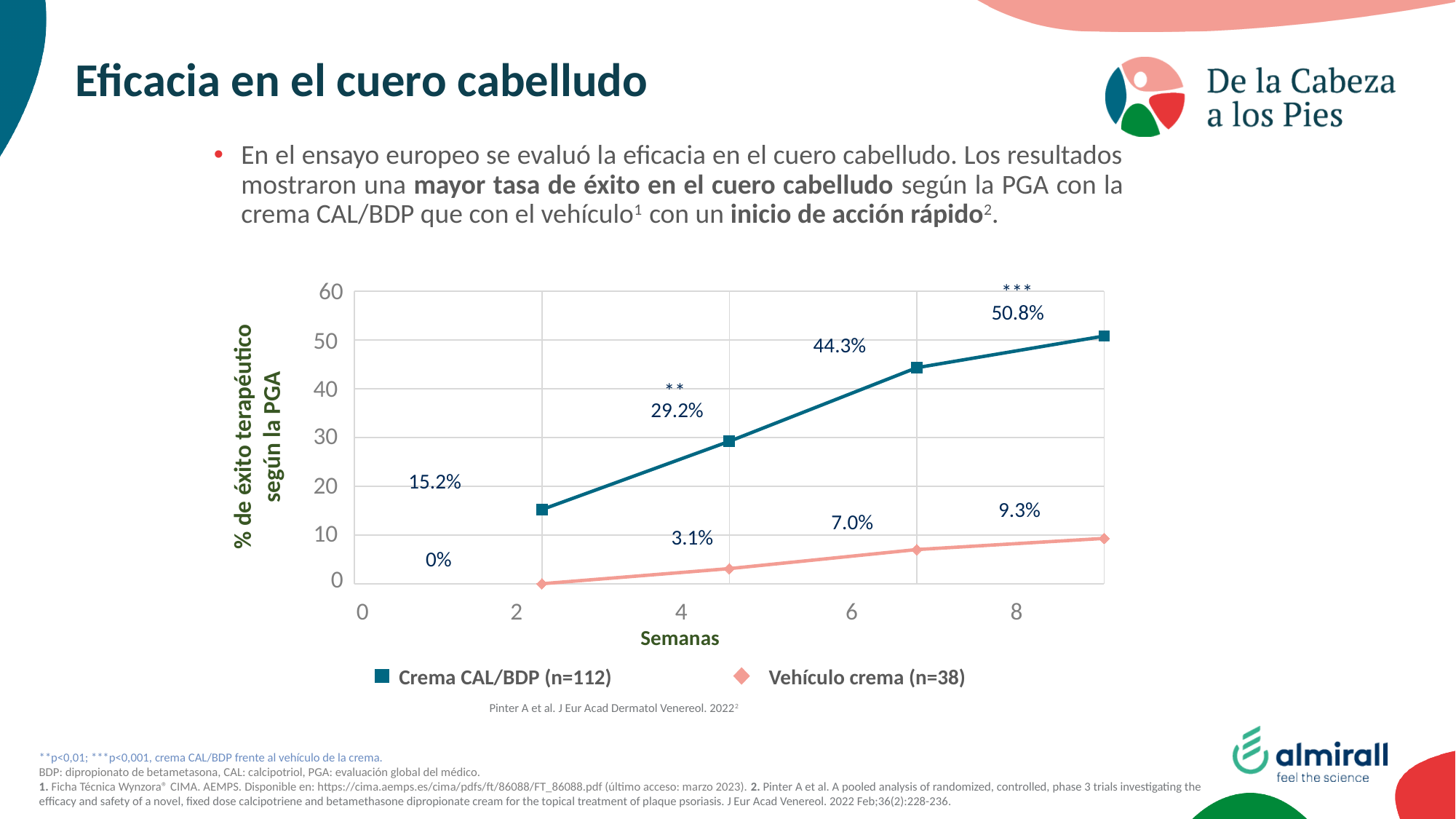
What is the difference between the final values of Crema CAL/BDP (n=112) and Vehículo crema (n=38)? 41.5% Which series has the higher value at the third data point: Crema CAL/BDP (n=112) or Vehículo crema (n=38)? Crema CAL/BDP (n=112) What is the highest value shown for Vehículo crema (n=38)? 9.3% Do the values for Crema CAL/BDP (n=112) rise or fall as the weeks increase? rise What is the value of the third data point for Vehículo crema (n=38)? 7.0% How many series does the legend list? 2 What is the value of the second data point for Crema CAL/BDP (n=112)? 29.2% What is the value of the last (rightmost) data point for Crema CAL/BDP (n=112)? 50.8% What type of chart is shown on the slide? line chart What is the label of the x axis? Semanas What is the value of the first data point for Vehículo crema (n=38)? 0% How many data points are plotted for the Crema CAL/BDP (n=112) series? 4